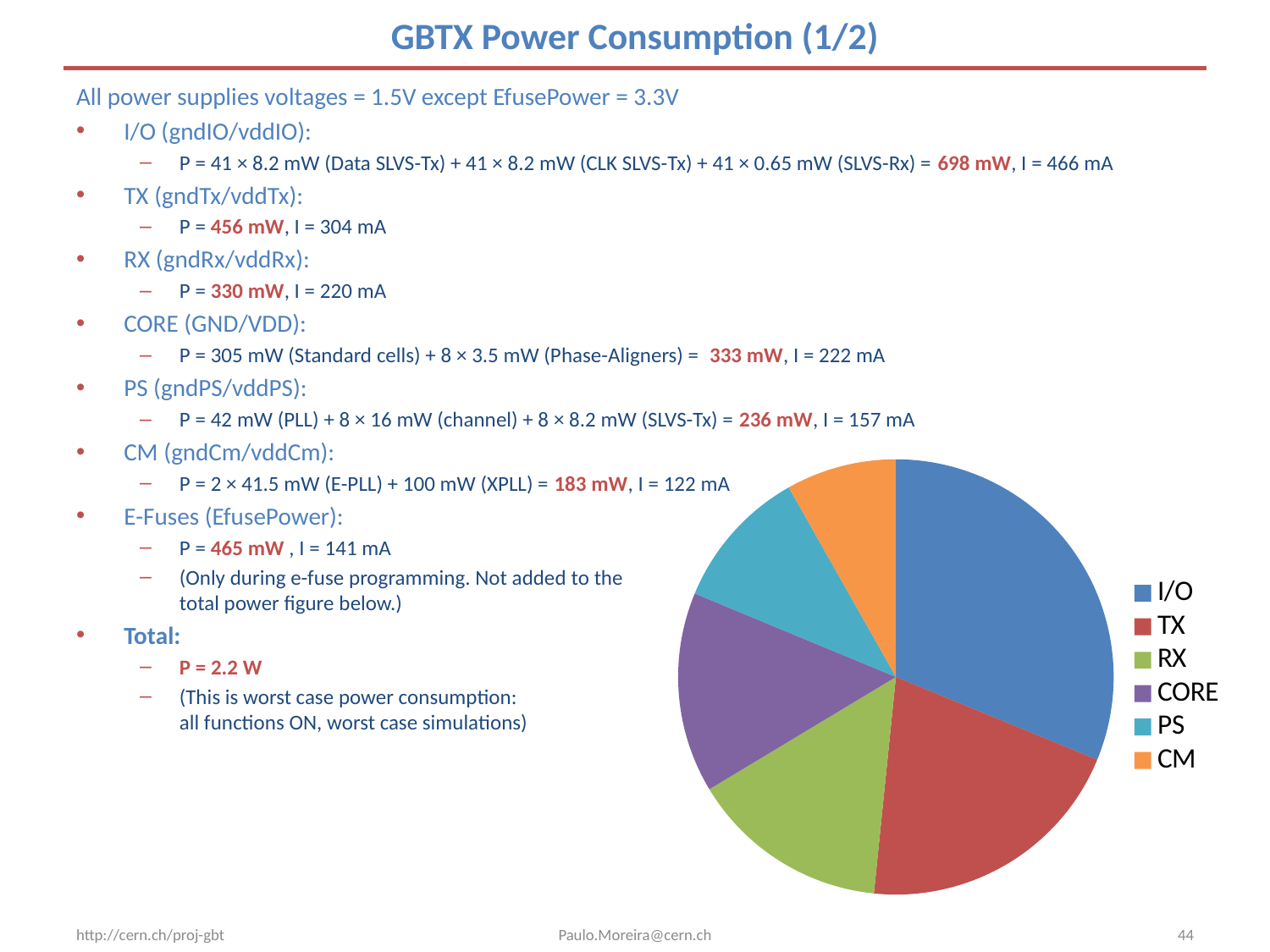
How many entries does the pie chart's legend list? 6 Which category has the smallest slice in the pie chart? CM How many slices does the pie chart have? 6 In the pie chart, which slice is larger, TX or PS? TX Which legend entry is listed first in the pie chart's legend? I/O Which category has the largest slice in the pie chart? I/O In the pie chart, which slice is larger, PS or CM? PS What colour is the I/O slice in the pie chart? blue In the pie chart, which slice is larger, TX or RX? TX What kind of chart is shown on the slide? pie chart